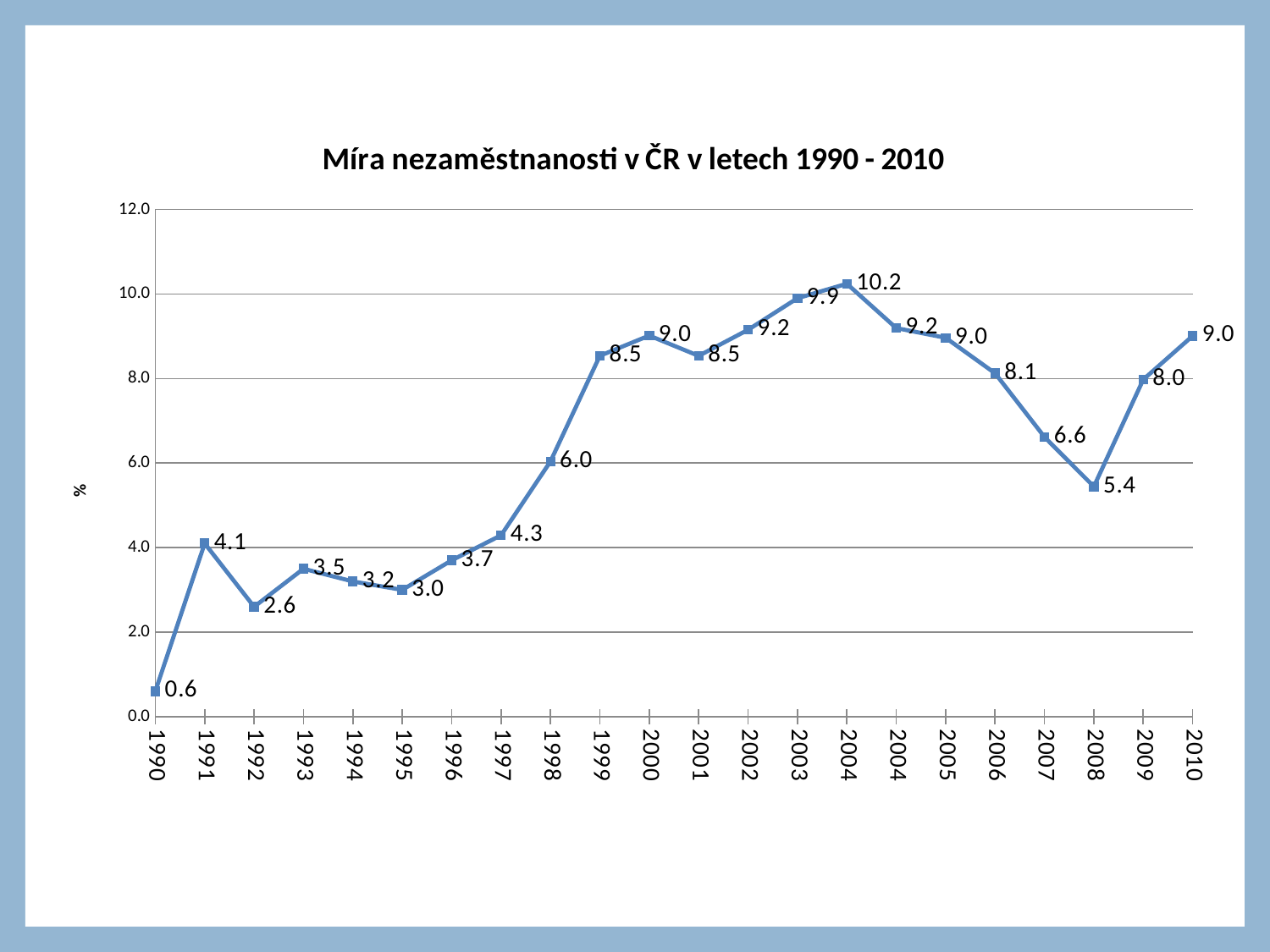
What is the title of the chart? Míra nezaměstnanosti v ČR v letech 1990 - 2010 Which year has the lowest value on the chart? 1990 How many data points are plotted on the line? 22 What value is plotted for 1998? 6.0 What is the difference between the values for 2007 and 2008? 1.2 What value is plotted for 2010? 9.0 What is the unemployment rate shown for 1990? 0.6 What kind of chart is shown on the slide? line chart Is the value for 2003 greater or less than 8.0? greater Which year has the larger value, 1991 or 1992? 1991 What value is plotted for 2008? 5.4 What is the highest value plotted on the chart? 10.2